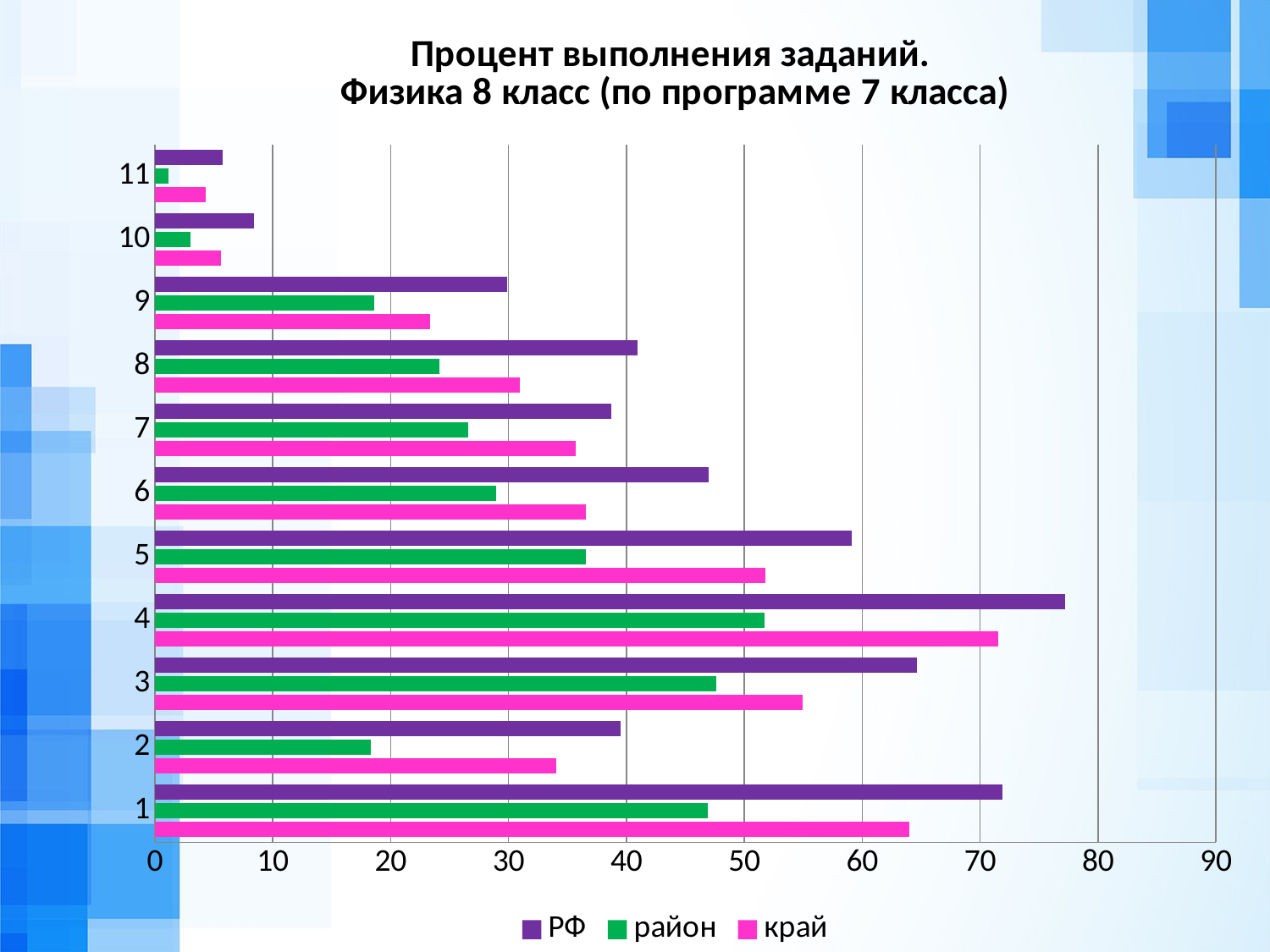
How many task categories are shown on the vertical axis? 11 Which series is shown in green in the legend? район For which task is the край value the highest? 4 For which task is the РФ value the highest? 4 What kind of chart is shown on the slide? bar chart Is the РФ value for task 6 greater or less than 50? less Is the район value for task 9 greater or less than 20? less For task 3, which is larger: the РФ value or the край value? РФ For which task is the район value the lowest? 11 How many series does the legend list? 3 Is the край value for task 1 greater or less than 60? greater